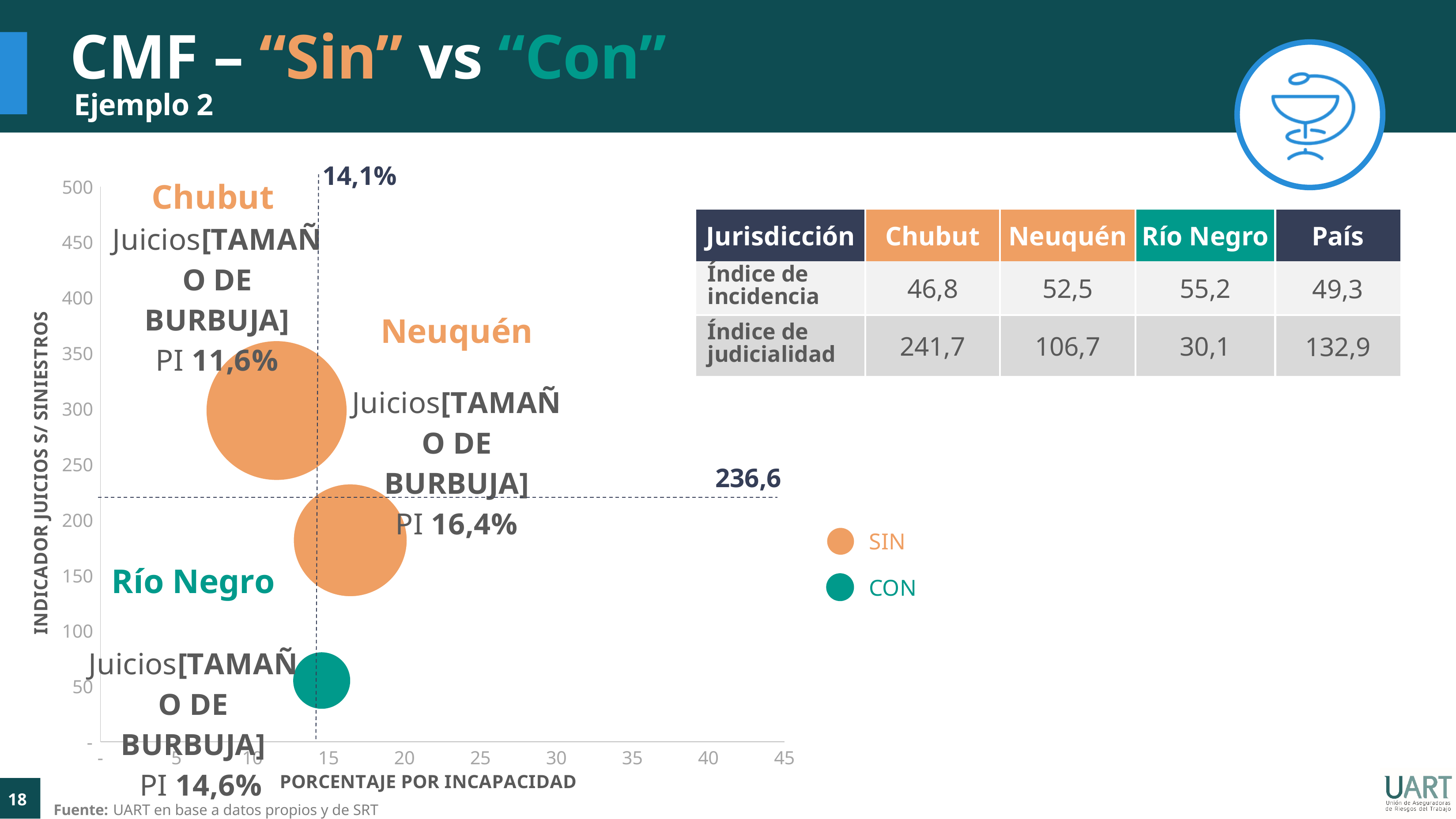
What is the PI value labelled for Río Negro? 14,6% Is the value on the 'Indicador juicios s/ siniestros' axis for Chubut greater or less than 250? greater Is the value on the 'Indicador juicios s/ siniestros' axis for Río Negro greater or less than 100? less Which jurisdiction has the lowest PI value in the chart? Chubut What value is labelled on the vertical dashed reference line in the chart? 14,1% What is the PI value labelled for Neuquén? 16,4% What kind of chart is shown on the left of the slide? bubble chart How many series does the chart legend list? 2 What is the difference between the PI values of Neuquén and Chubut? 4,8% Which jurisdiction has the highest PI value in the chart? Neuquén How many bubbles (jurisdictions) are plotted in the chart? 3 What is the PI (porcentaje por incapacidad) value labelled for Chubut? 11,6%